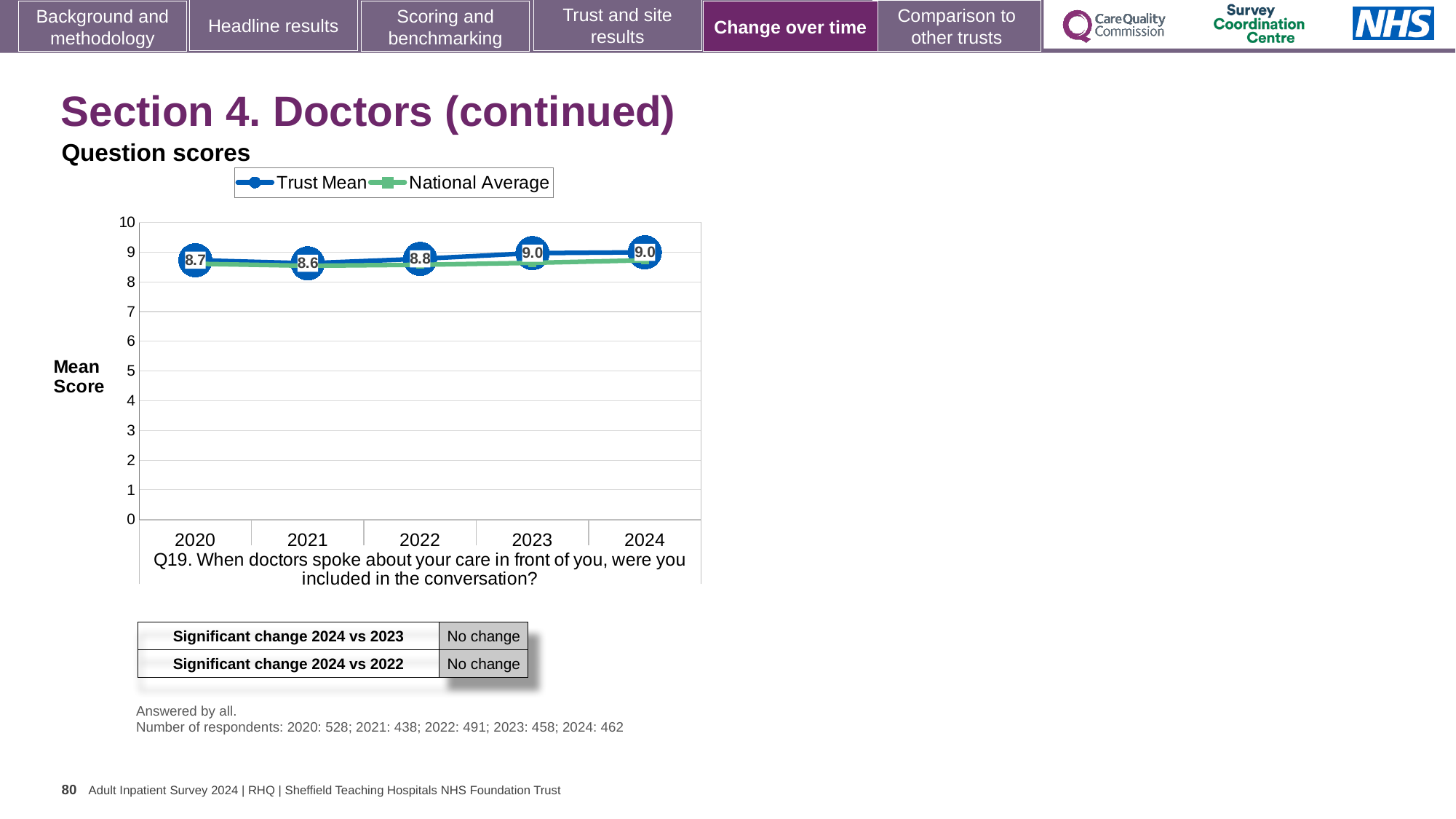
What is the Trust Mean score for 2020? 8.7 In which year is the Trust Mean score lowest? 2021 What kind of chart is shown on the slide? Line chart What is the Trust Mean score for 2021? 8.6 Is the National Average value for 2024 greater or less than 8? greater What is the Trust Mean score for 2024? 9.0 What is the label on the y axis of the chart? Mean Score How many series does the legend list? 2 Which year has the higher Trust Mean score, 2021 or 2023? 2023 What is the difference between the Trust Mean scores for 2024 and 2021? 0.4 How many years are plotted on the x axis? 5 Does the Trust Mean score rise or fall from 2021 to 2024? Rise